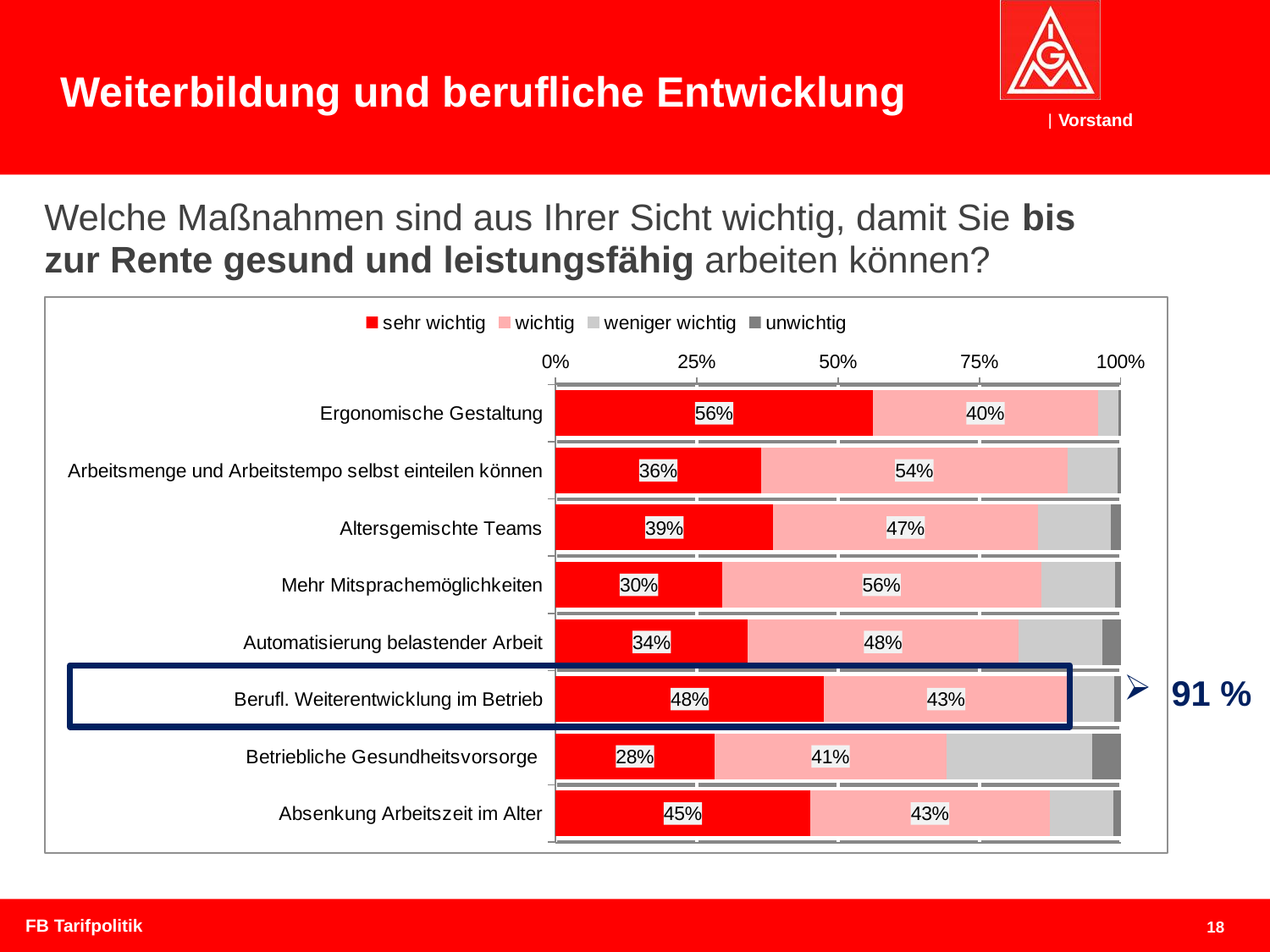
How many measures (categories) are shown in the chart? 8 Which measure has the lowest "sehr wichtig" share? Betriebliche Gesundheitsvorsorge Which measure has the highest "wichtig" share? Mehr Mitsprachemöglichkeiten What percentage of respondents rated "Ergonomische Gestaltung" as "sehr wichtig"? 56% What type of chart is shown on the slide? Stacked bar chart Which has a larger "sehr wichtig" share: "Altersgemischte Teams" or "Automatisierung belastender Arbeit"? Altersgemischte Teams Which measure has the highest "sehr wichtig" share? Ergonomische Gestaltung How many series does the legend list? 4 What is the "sehr wichtig" value for "Absenkung Arbeitszeit im Alter"? 45% What is the difference between the "sehr wichtig" values for "Ergonomische Gestaltung" and "Arbeitsmenge und Arbeitstempo selbst einteilen können"? 20 percentage points What is the "wichtig" value for "Betriebliche Gesundheitsvorsorge"? 41% What is the combined share of "sehr wichtig" and "wichtig" for "Berufl. Weiterentwicklung im Betrieb"? 91%